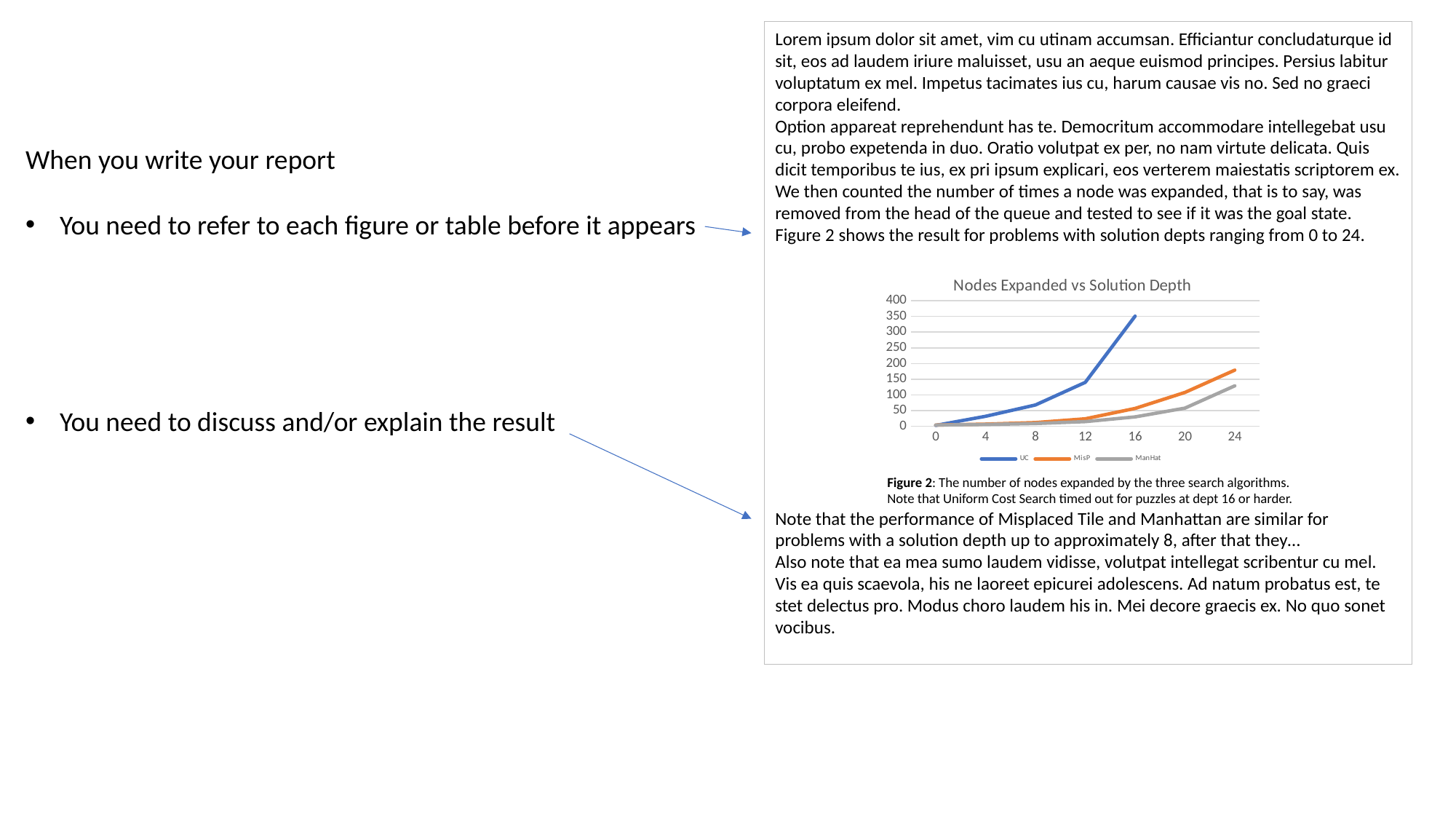
Is the value of the ManHat series at solution depth 24 greater or less than 150? less Is the value of the MisP series at solution depth 24 greater or less than 150? greater What is the highest value shown on the chart's vertical axis? 400 At solution depth 24, which series has the larger value, MisP or ManHat? MisP Is the value of the UC series at solution depth 12 greater or less than 100? greater Which series is drawn in orange in the chart? MisP Do the values of the MisP series rise or fall as solution depth increases? rise How many series does the chart's legend list? 3 Which series has the highest value at solution depth 16? UC What is the title of the chart? Nodes Expanded vs Solution Depth What kind of chart is shown on the slide? line chart